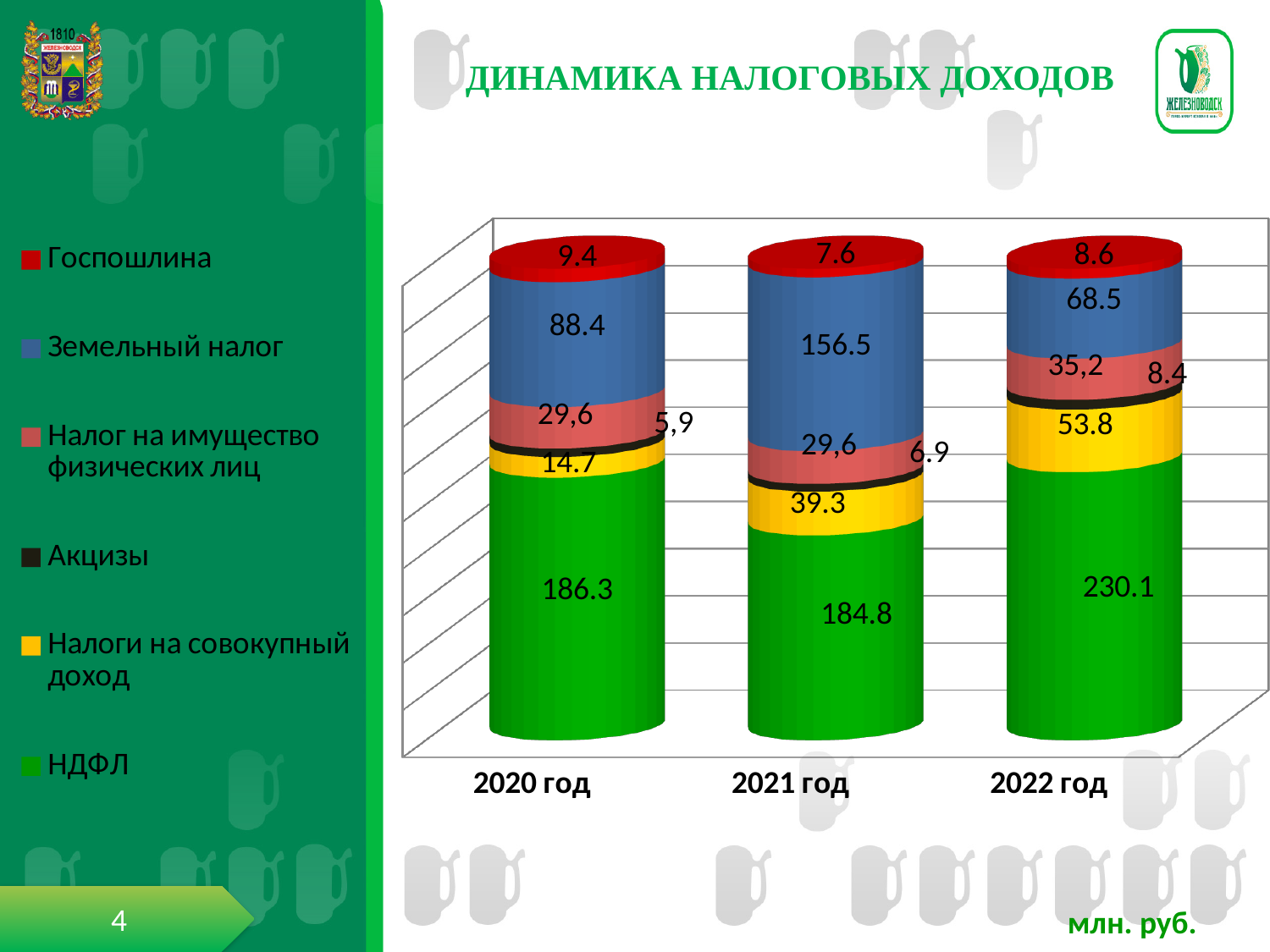
What is the value of Налоги на совокупный доход for 2020 год? 14.7 In which year is the НДФЛ value lowest? 2021 год How many series does the legend list? 6 Which is larger: Налоги на совокупный доход in 2021 год or in 2022 год? 2022 год What is the total of the stacked bar for 2020 год? 334.3 In which year is the Земельный налог value highest? 2021 год What is the value of Земельный налог for 2021 год? 156.5 What is the value of НДФЛ for 2022 год? 230.1 What is the value of Акцизы for 2022 год? 8.4 How many years are shown on the x axis? 3 What is the value of Госпошлина for 2021 год? 7.6 What is the difference between the НДФЛ values for 2022 год and 2020 год? 43.8